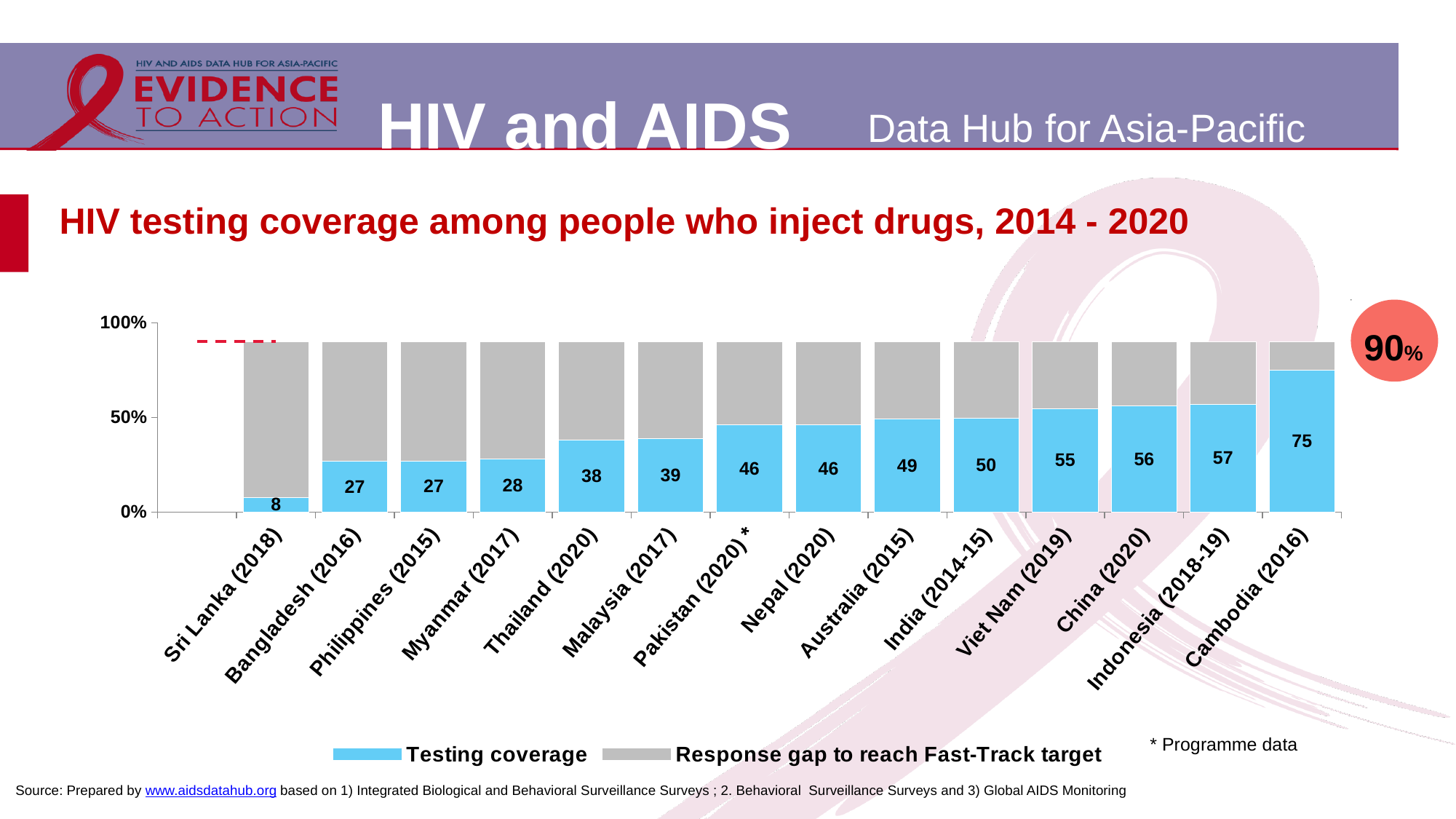
What is the testing coverage value shown for Sri Lanka (2018)? 8 What kind of chart is shown on the slide? Stacked bar chart How many series does the legend list? 2 What is the testing coverage value shown for Cambodia (2016)? 75 Which has a higher testing coverage value, Viet Nam (2019) or Malaysia (2017)? Viet Nam (2019) Which country has the lowest testing coverage in the chart? Sri Lanka (2018) Which country has the highest testing coverage in the chart? Cambodia (2016) Which legend entry is shown in grey? Response gap to reach Fast-Track target Is the testing coverage value for Indonesia (2018-19) greater or less than 50%? greater What is the testing coverage value shown for Thailand (2020)? 38 How many countries are shown on the x axis of the chart? 14 What is the difference between the testing coverage values for Cambodia (2016) and Sri Lanka (2018)? 67